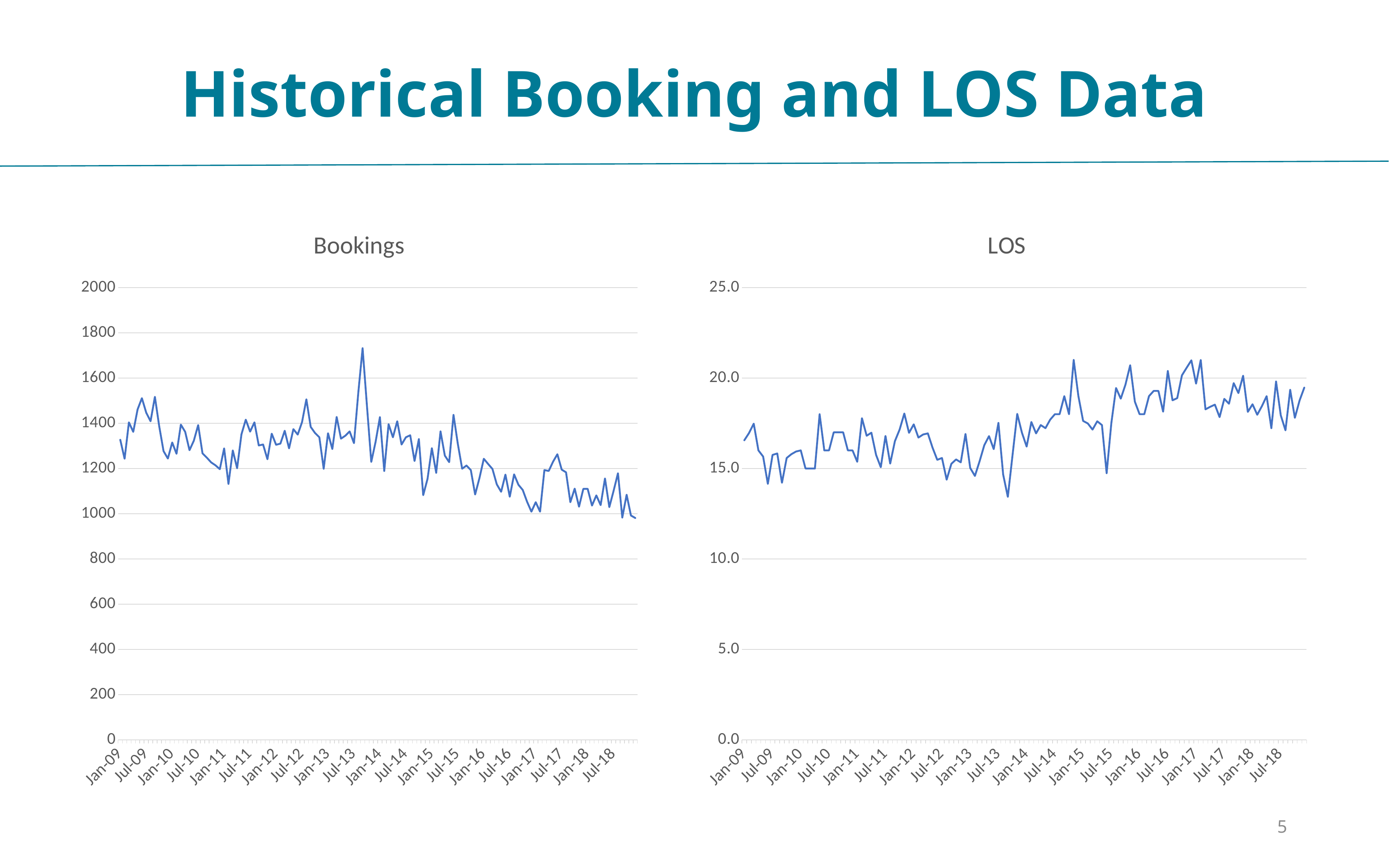
In the LOS chart, do the values generally rise or fall from Jan-09 to Jul-18? rise In the Bookings chart, do the values generally rise or fall from Jan-09 to Jul-18? fall In the LOS chart, is the lowest point of the line greater or less than 15.0? less In the LOS chart, is the highest peak of the line greater or less than 20.0? greater In the Bookings chart, is the value at Jan-17 greater or less than 1200? less What kind of chart is the LOS chart? line chart What is the title of the chart on the right side of the slide? LOS What is the maximum value shown on the y axis of the Bookings chart? 2000 What kind of chart is the Bookings chart? line chart